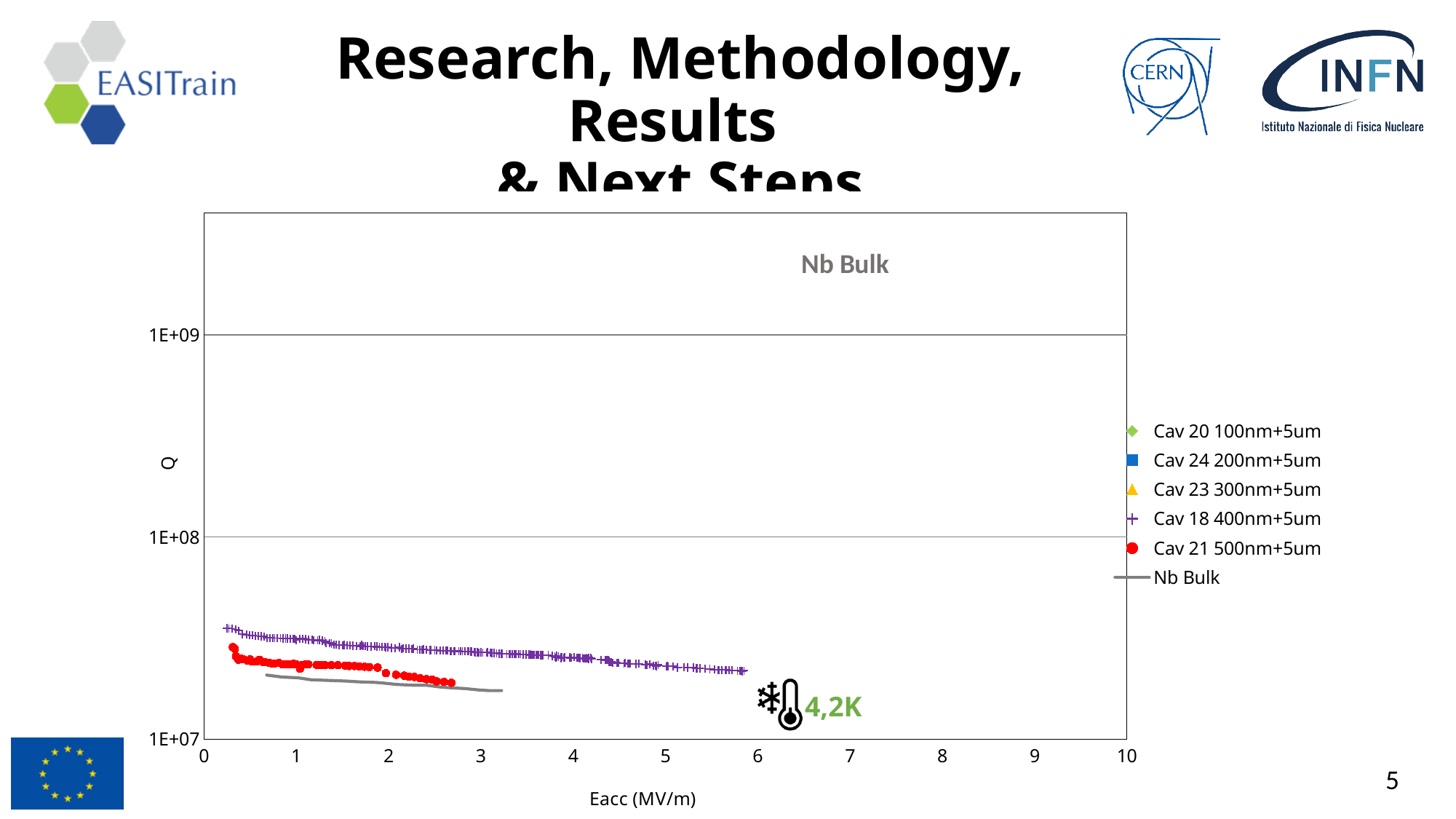
At Eacc 2, which series has the higher Q: Cav 18 400nm+5um or Cav 21 500nm+5um? Cav 18 400nm+5um Is the Q value for Cav 18 400nm+5um at Eacc 2 greater or less than 1E+08? less At Eacc 2, which series has the lower Q: Cav 21 500nm+5um or Nb Bulk? Nb Bulk What is the label of the x axis? Eacc (MV/m) What kind of chart is shown on the slide? Scatter chart What is the label of the y axis? Q How many series does the legend list? 6 Do the Q values for Cav 18 400nm+5um rise or fall as Eacc increases? Fall Is the Q value for Cav 21 500nm+5um at Eacc 1 greater or less than 1E+07? greater What is the highest tick value shown on the x axis? 10 Which plotted series reaches the highest Eacc value? Cav 18 400nm+5um Do the Q values for Cav 21 500nm+5um rise or fall as Eacc increases? Fall